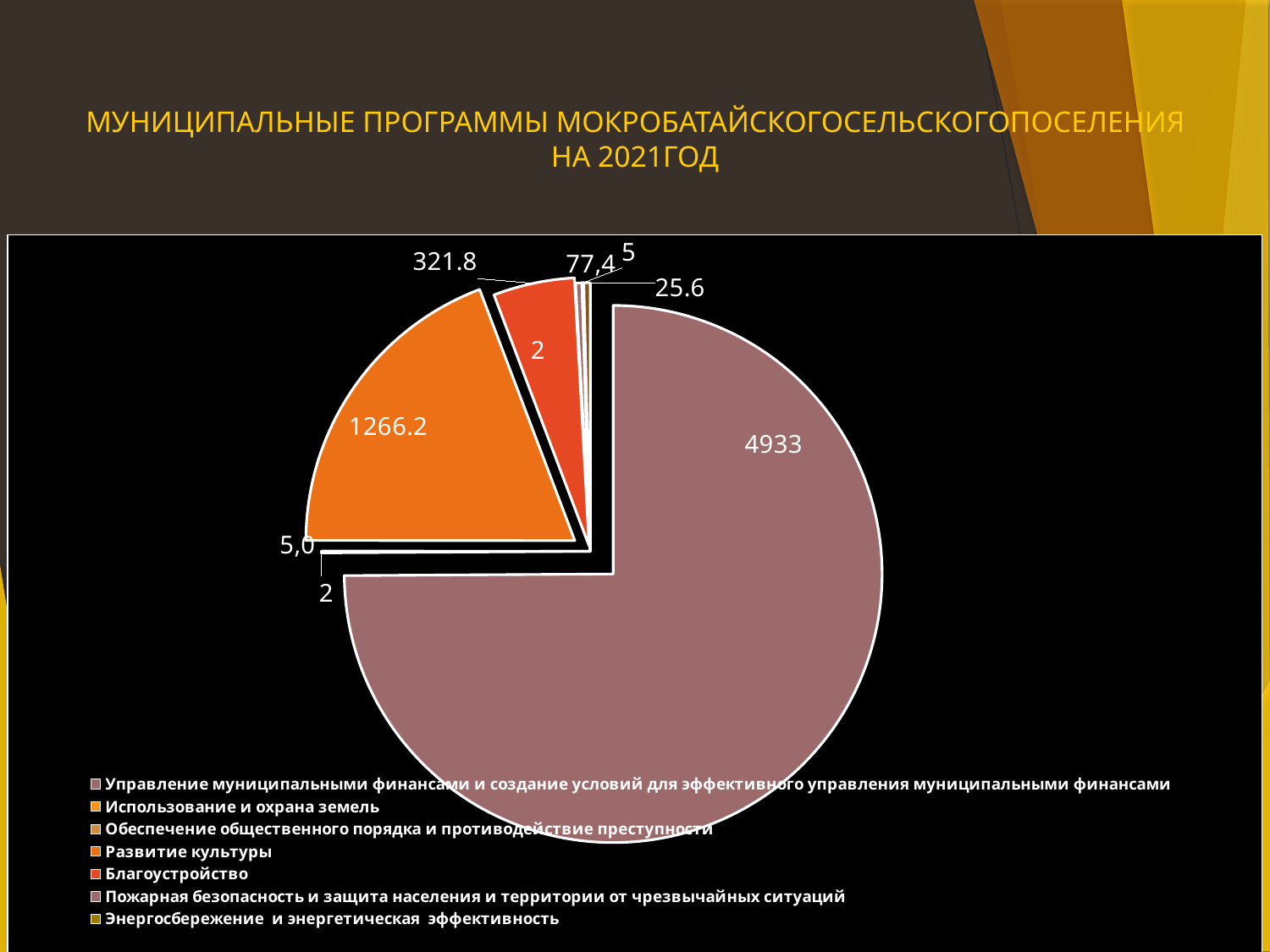
How many entries does the legend of the pie chart list? 7 Is the value of the largest slice of the pie chart greater or less than 4000? greater Which is larger, the slice labelled 4933 or the slice labelled 1266.2? 4933 What is the difference between the slice labelled 4933 and the slice labelled 1266.2? 3666.8 What year is named in the slide title above the pie chart? 2021 Which legend entry corresponds to the largest (mauve) slice of the pie chart? Управление муниципальными финансами и создание условий для эффективного управления муниципальными финансами What is the value printed on the largest slice of the pie chart? 4933 What kind of chart is shown on the slide? pie chart What value is printed on the large orange slice of the pie chart? 1266.2 Is the value of the large orange slice of the pie chart greater or less than 1000? greater